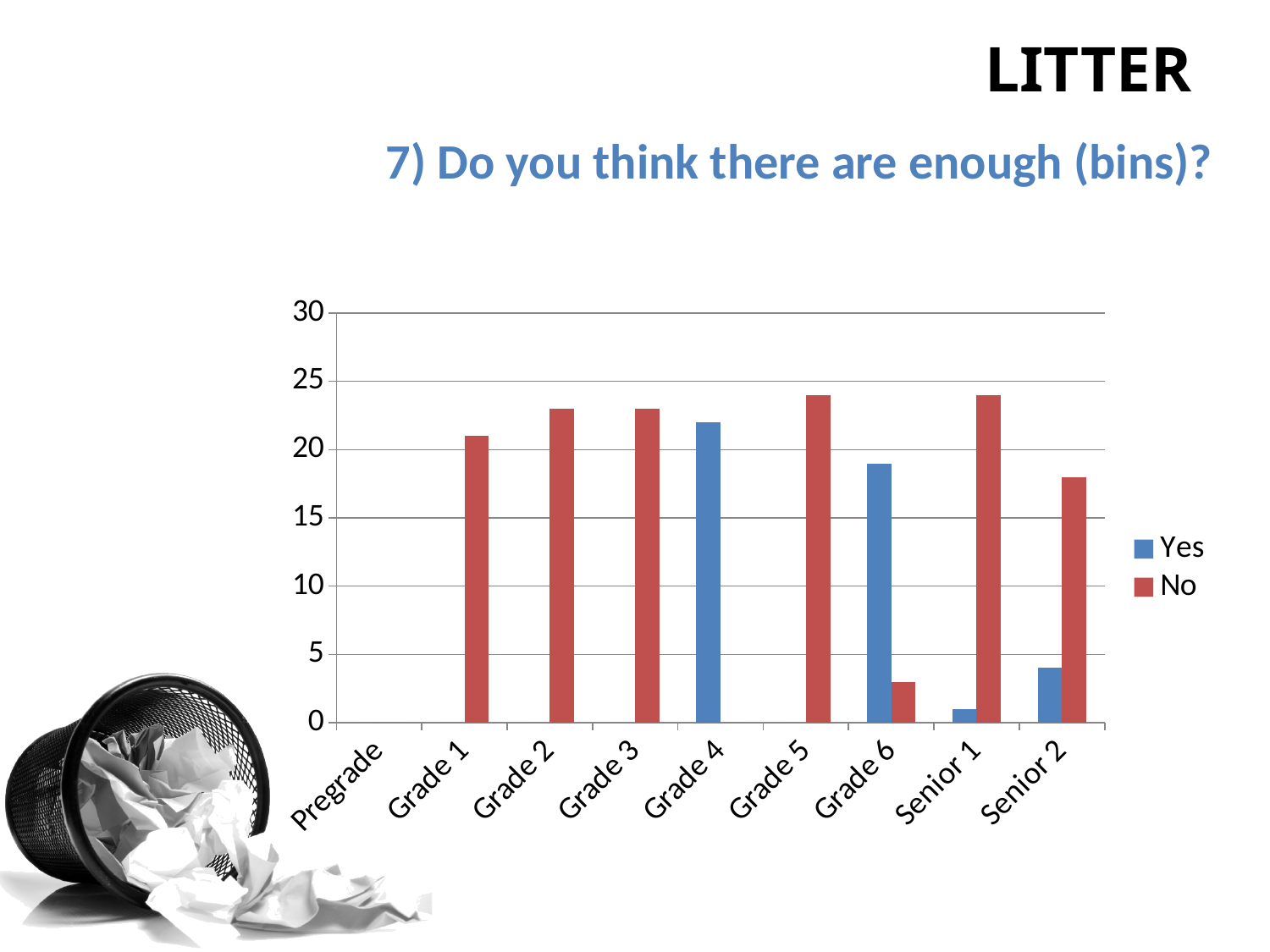
How many series does the legend list? 2 Is the Yes value for Grade 4 greater or less than 20? greater How many categories are shown on the x axis? 9 What colour represents the No series in the chart? red Is the No value for Grade 6 greater or less than 5? less For Grade 6, which is larger, the Yes value or the No value? Yes For Senior 1, which is larger, the Yes value or the No value? No Which category has the lowest non-zero value for the Yes series? Senior 1 Is the No value for Senior 2 greater or less than 20? less Which category has the highest value for the Yes series? Grade 4 What kind of chart is shown on the slide? bar chart